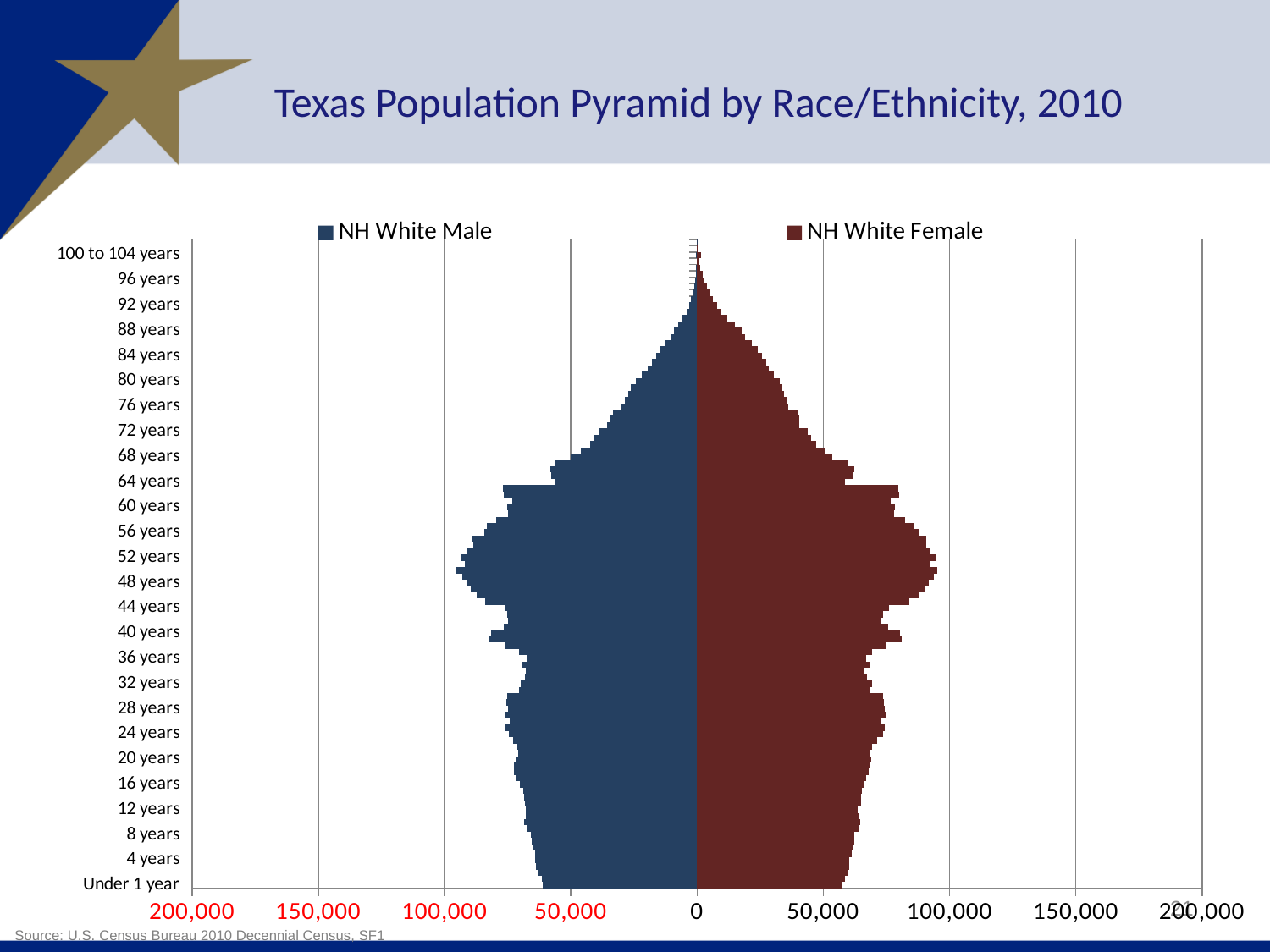
Do the NH White Female values generally increase or decrease going from 100 to 104 years down to 48 years? increase Is the NH White Female value for 16 years greater or less than 50,000? greater How many series does the legend list? 2 What is the title of the chart? Texas Population Pyramid by Race/Ethnicity, 2010 At 88 years, which is larger: the NH White Male value or the NH White Female value? NH White Female Is the NH White Female value for 48 years greater or less than 50,000? greater What kind of chart is shown on the slide? Bar chart (population pyramid) Is the NH White Male value for 80 years greater or less than 50,000? less What are the two series named in the legend? NH White Male and NH White Female